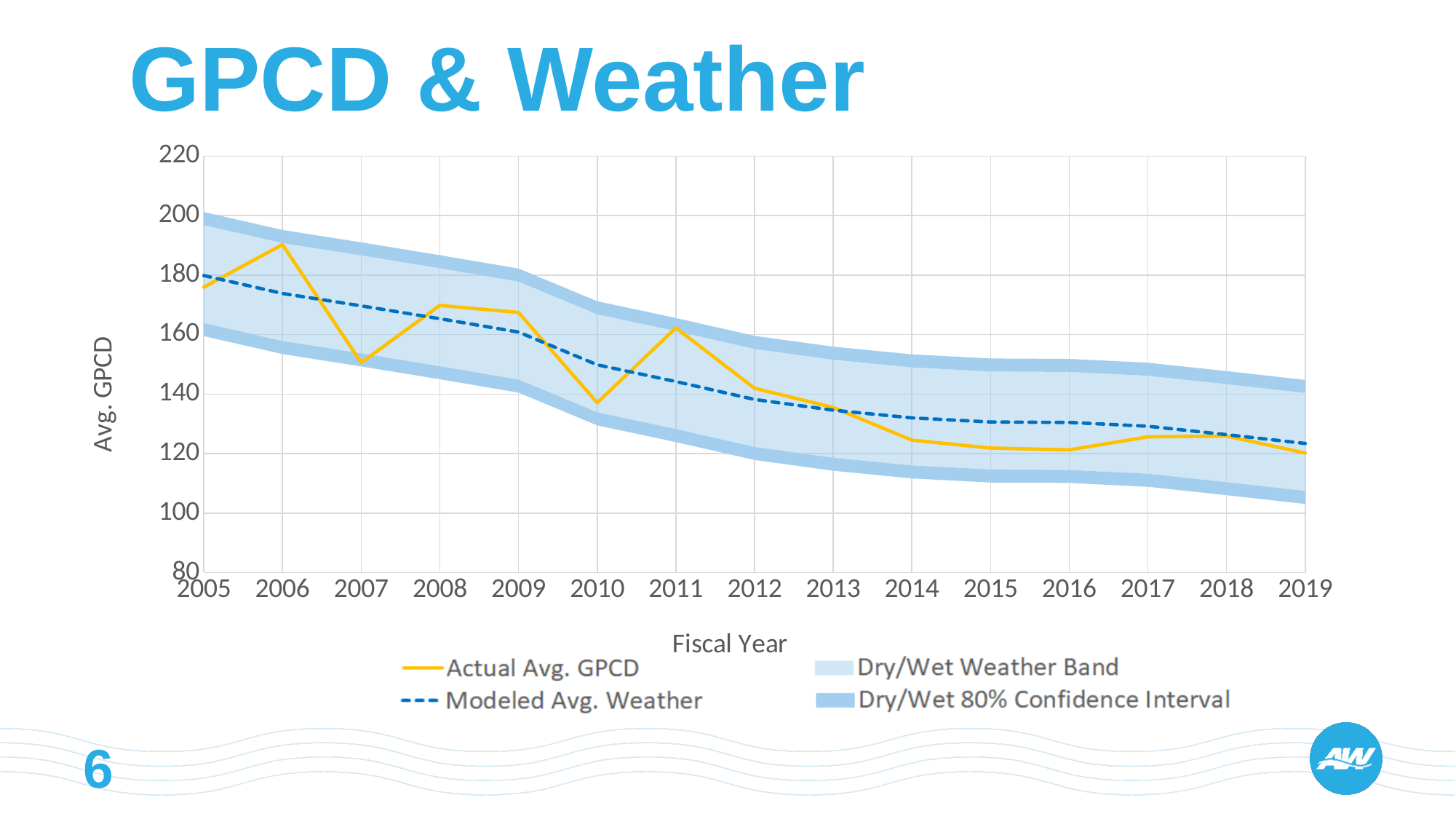
Is the Actual Avg. GPCD for 2010 greater or less than 140? less What kind of chart is shown on the slide? combination area and line chart Which year has the larger Actual Avg. GPCD, 2009 or 2010? 2009 Is the Actual Avg. GPCD for 2005 greater or less than 160? greater What is the label on the y axis of the chart? Avg. GPCD How many series does the legend list? 4 In which fiscal year is the Actual Avg. GPCD highest? 2006 Which year has the larger Actual Avg. GPCD, 2006 or 2007? 2006 Is the Actual Avg. GPCD for 2006 greater or less than 180? greater Does the Modeled Avg. Weather line rise or fall from 2005 to 2019? fall How many fiscal years are shown on the x axis? 15